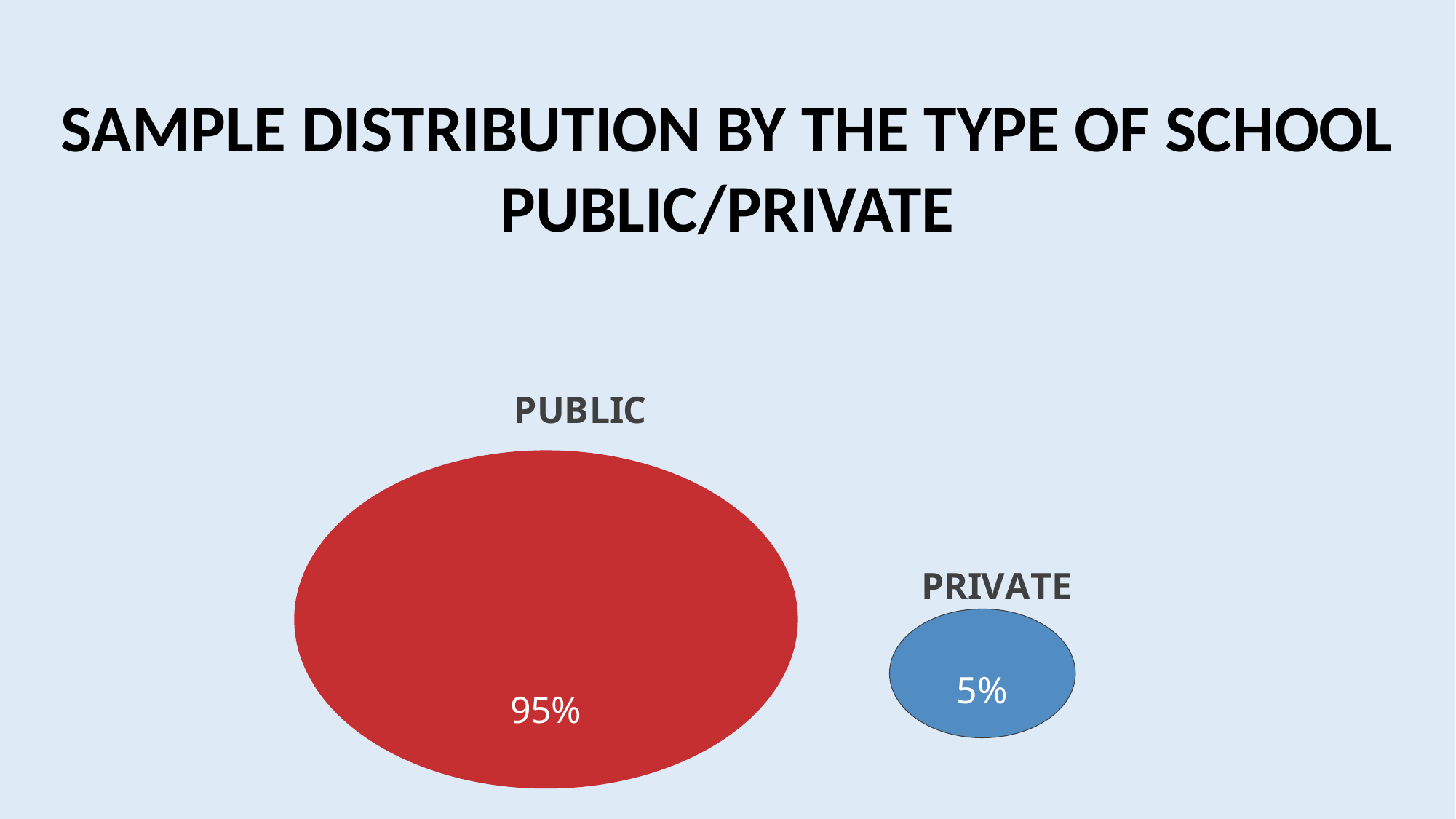
Is the value for Public greater or less than 50%? greater What percentage of the sample is from public schools? 95% What kind of chart is shown on the slide? Bubble chart Which is larger, the share for Private or the share for Public? Public Which type of school has the smaller share of the sample? Private What colour is the circle representing public schools? Red What is the difference between the public and private shares of the sample? 90% Which type of school has the larger share of the sample? Public What do the public and private shares add up to? 100% What percentage of the sample is from private schools? 5% How many school types are shown in the chart? 2 What is the title of the slide? SAMPLE DISTRIBUTION BY THE TYPE OF SCHOOL PUBLIC/PRIVATE